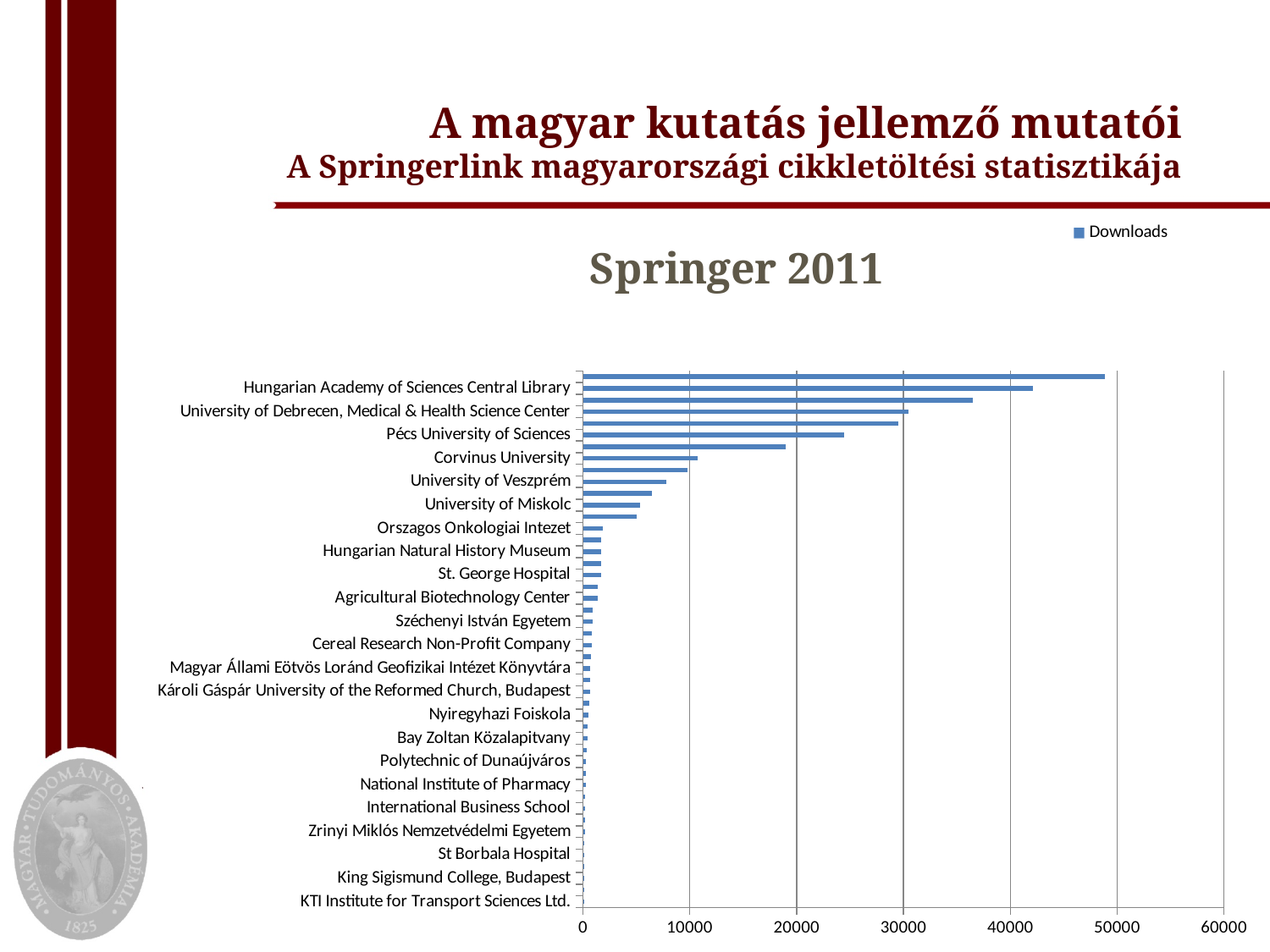
Do the bar values increase or decrease going from the top of the chart to the bottom? decrease Which has more downloads, Pécs University of Sciences or Corvinus University? Pécs University of Sciences Is the value for Corvinus University greater or less than 20000? less Is the value for KTI Institute for Transport Sciences Ltd. greater or less than 10000? less How many series does the legend list? 1 What is the title of the chart? Springer 2011 What is the name of the series shown in the legend? Downloads Which has more downloads, Hungarian Academy of Sciences Central Library or University of Miskolc? Hungarian Academy of Sciences Central Library Is the value for University of Miskolc greater or less than 10000? less What kind of chart is shown on the slide? Bar chart